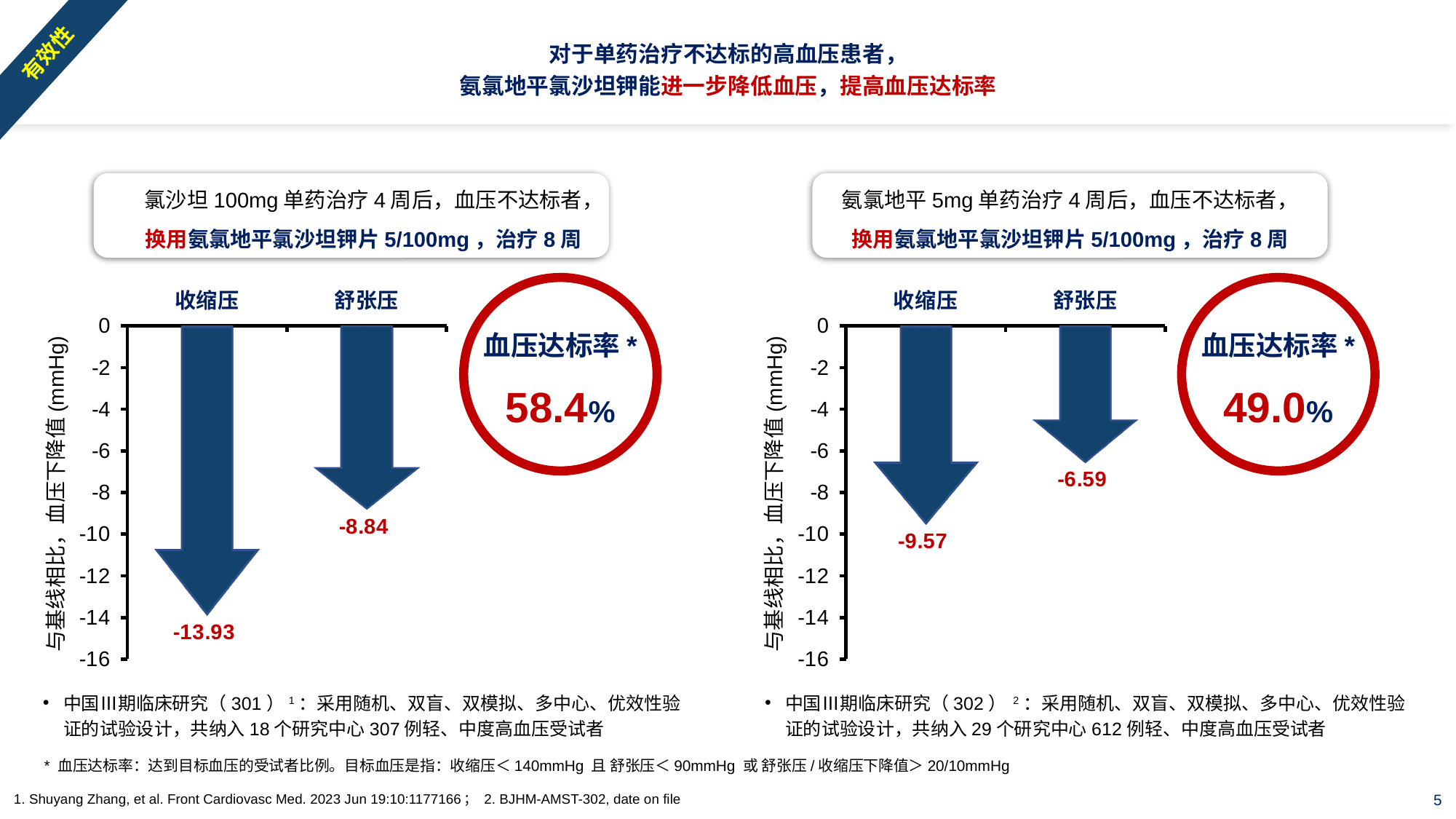
In the left chart, what is the value for 收缩压? -13.93 What kind of chart is the right chart? bar chart What is the y-axis label of the left chart? 与基线相比，血压下降值 (mmHg) In the left chart, what is the value for 舒张压? -8.84 In the left chart, which category shows the larger reduction, 收缩压 or 舒张压? 收缩压 In the right chart, what is the difference between the 收缩压 and 舒张压 values? 2.98 In the left chart, what is the difference between the 收缩压 and 舒张压 values? 5.09 In the right chart, what is the value for 舒张压? -6.59 Is the 收缩压 value in the right chart greater or less than -10? greater In the right chart, what is the value for 收缩压? -9.57 How many categories are plotted in the left chart? 2 In the right chart, which category has the smallest reduction? 舒张压